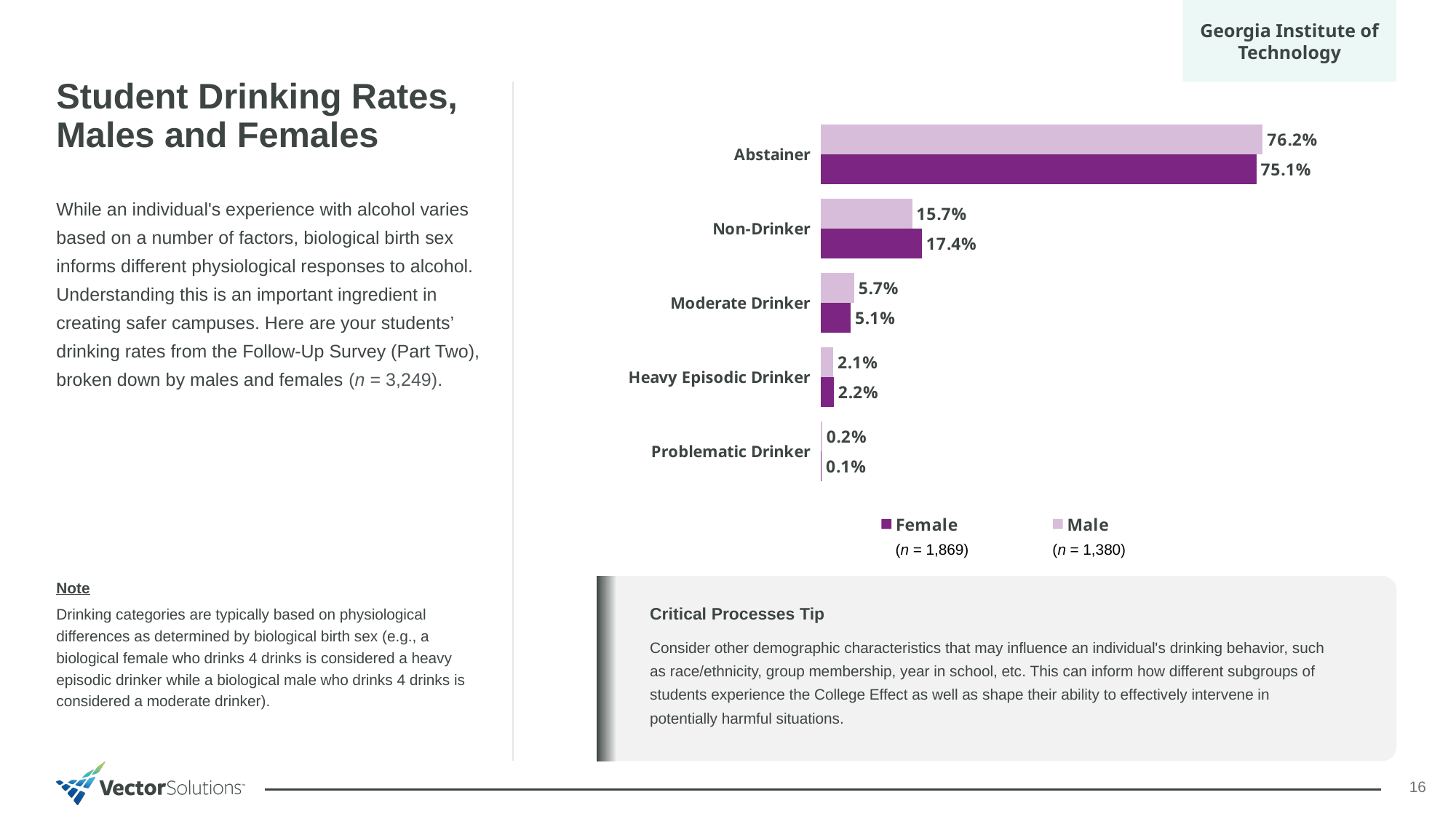
Which category has the highest Male value? Abstainer What sample size is shown for the Female series in the legend? n = 1,869 What is the difference between the Female and Male values for Non-Drinker? 1.7% Which category has the lowest Female value? Problematic Drinker What is the Male value for Problematic Drinker? 0.2% How many series does the legend list? 2 What is the Male value for Non-Drinker? 15.7% How many drinking categories are shown in the chart? 5 What kind of chart is shown on the slide? Bar chart What is the Female value for Moderate Drinker? 5.1% For Moderate Drinker, which is larger, the Male value or the Female value? Male What is the Female value for Abstainer? 75.1%